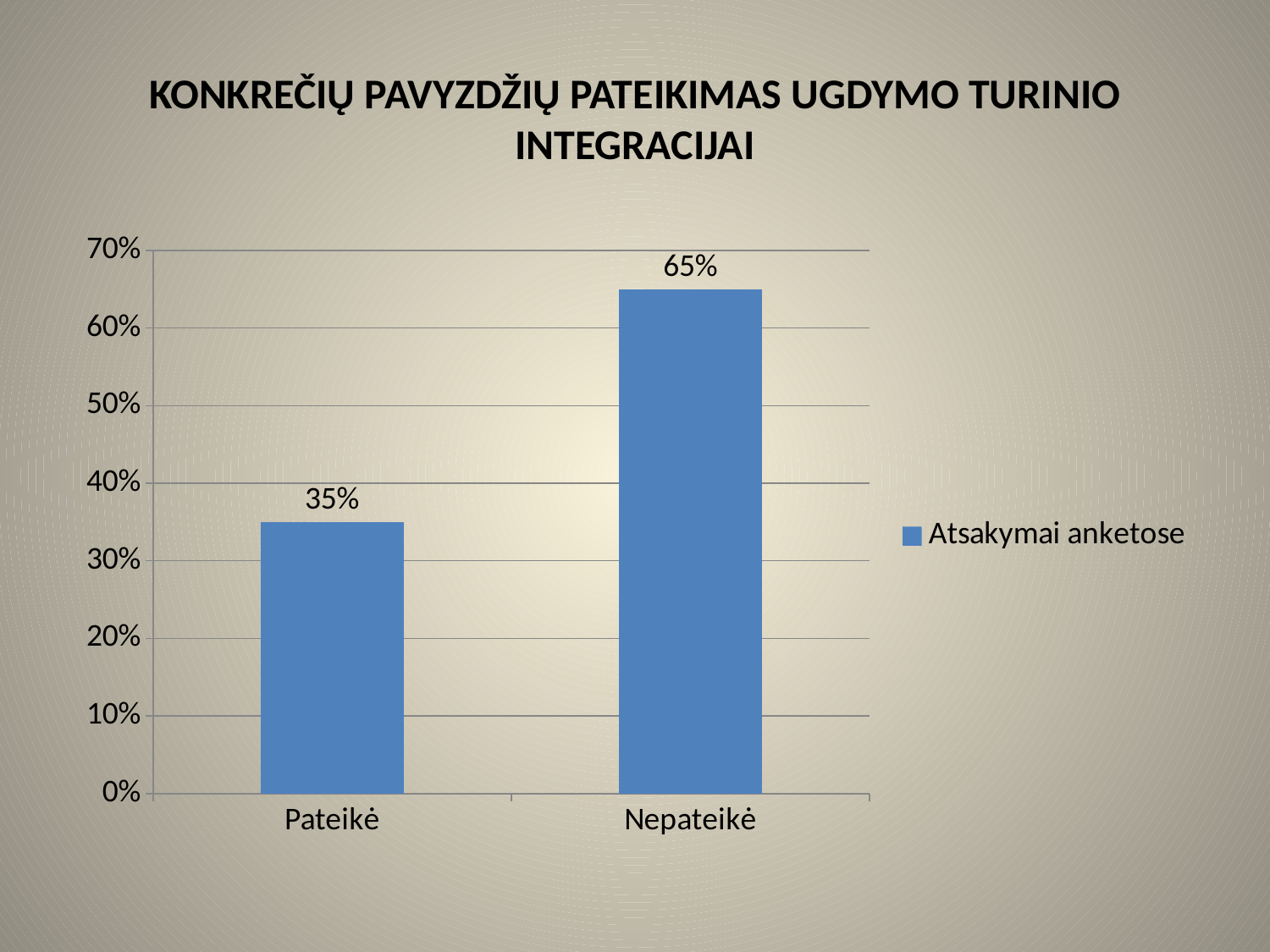
Which category has the lowest value? Pateikė What is the difference between the values for Nepateikė and Pateikė? 30% How many categories are shown on the x axis? 2 How many series does the legend list? 1 What is the value for Pateikė? 35% Is the value for Nepateikė greater or less than 60%? greater Which category has the highest value? Nepateikė Which is larger, the value for Pateikė or the value for Nepateikė? Nepateikė Is the value for Pateikė greater or less than 40%? less What is the name of the series shown in the legend? Atsakymai anketose What is the value for Nepateikė? 65% What kind of chart is shown on the slide? Bar chart